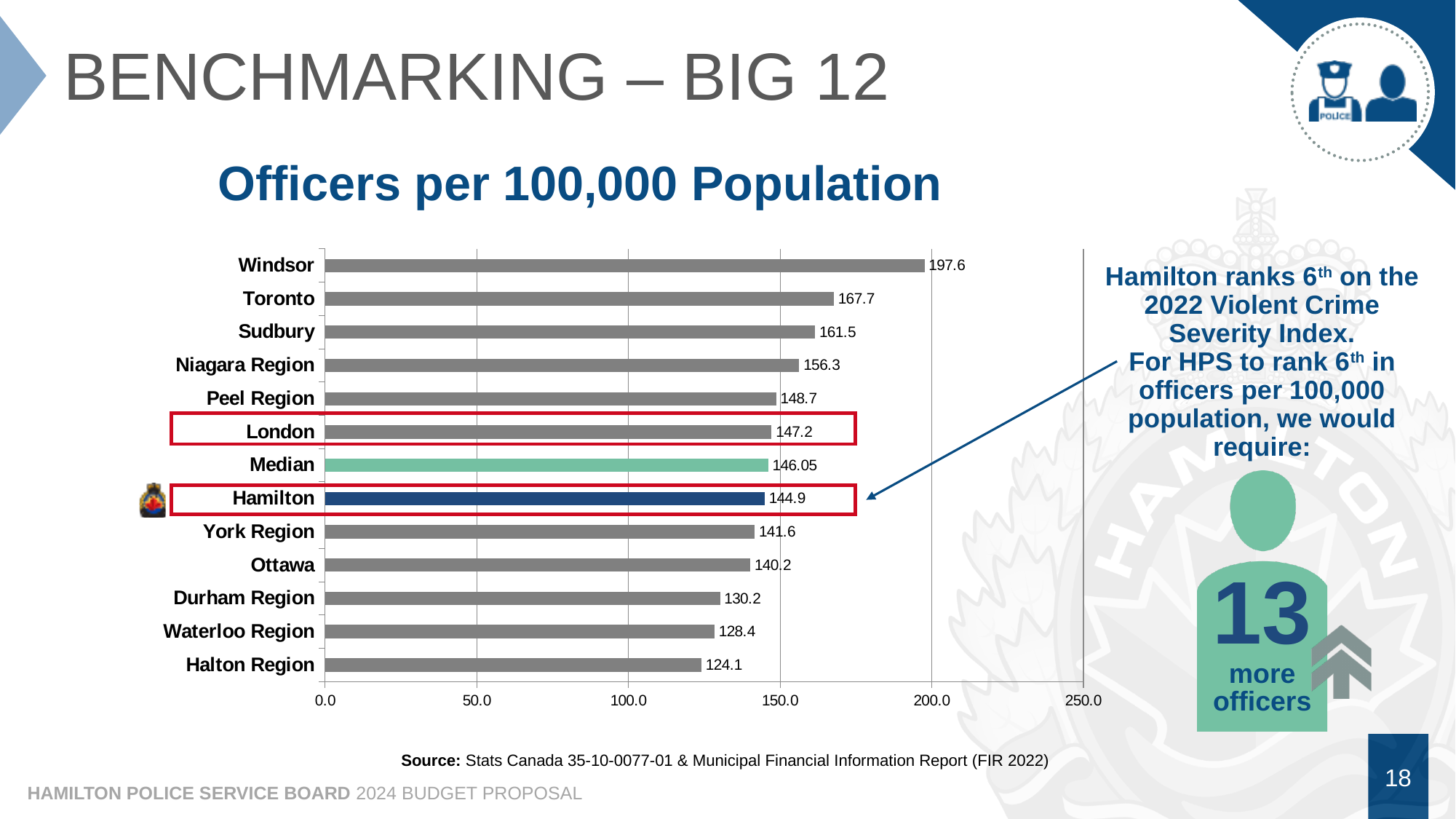
What is the difference between the values for London and Hamilton? 2.3 What is the value for Windsor? 197.6 What is the Median value shown in the chart? 146.05 Which category has the highest value? Windsor What is the difference between the values for Windsor and Toronto? 29.9 What is the title of the chart? Officers per 100,000 Population Which category has the lowest value? Halton Region What is the value for Hamilton in the Officers per 100,000 Population chart? 144.9 What kind of chart is shown on the slide? Bar chart What is the value for Halton Region? 124.1 Which is larger, the value for Peel Region or the value for Niagara Region? Niagara Region How many bars are plotted in the chart, including the Median bar? 13